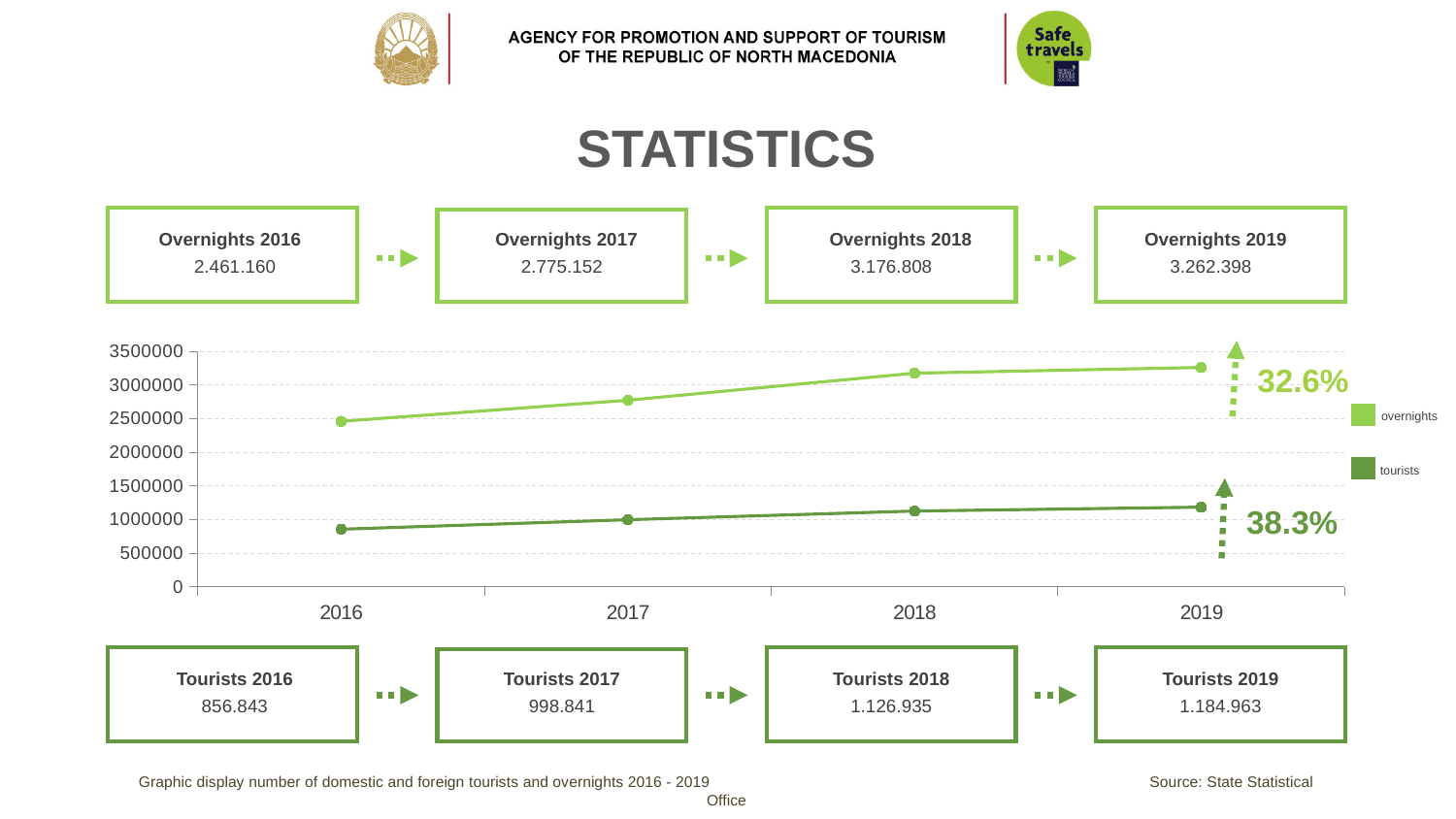
Which year has the highest number of overnights? 2019 What is the difference between tourists in 2019 and tourists in 2016? 328.120 What is the number of overnights in 2016? 2.461.160 Which year has the lowest number of tourists? 2016 What is the number of overnights in 2018? 3.176.808 How many years are plotted along the x axis of the chart? 4 Is the tourists value for 2018 greater or less than 1500000? less What is the difference between overnights in 2019 and overnights in 2016? 801.238 Do the overnights values rise or fall from 2016 to 2019? rise How many series does the chart legend list? 2 What is the number of tourists in 2019? 1.184.963 What type of chart is shown on the slide? line chart